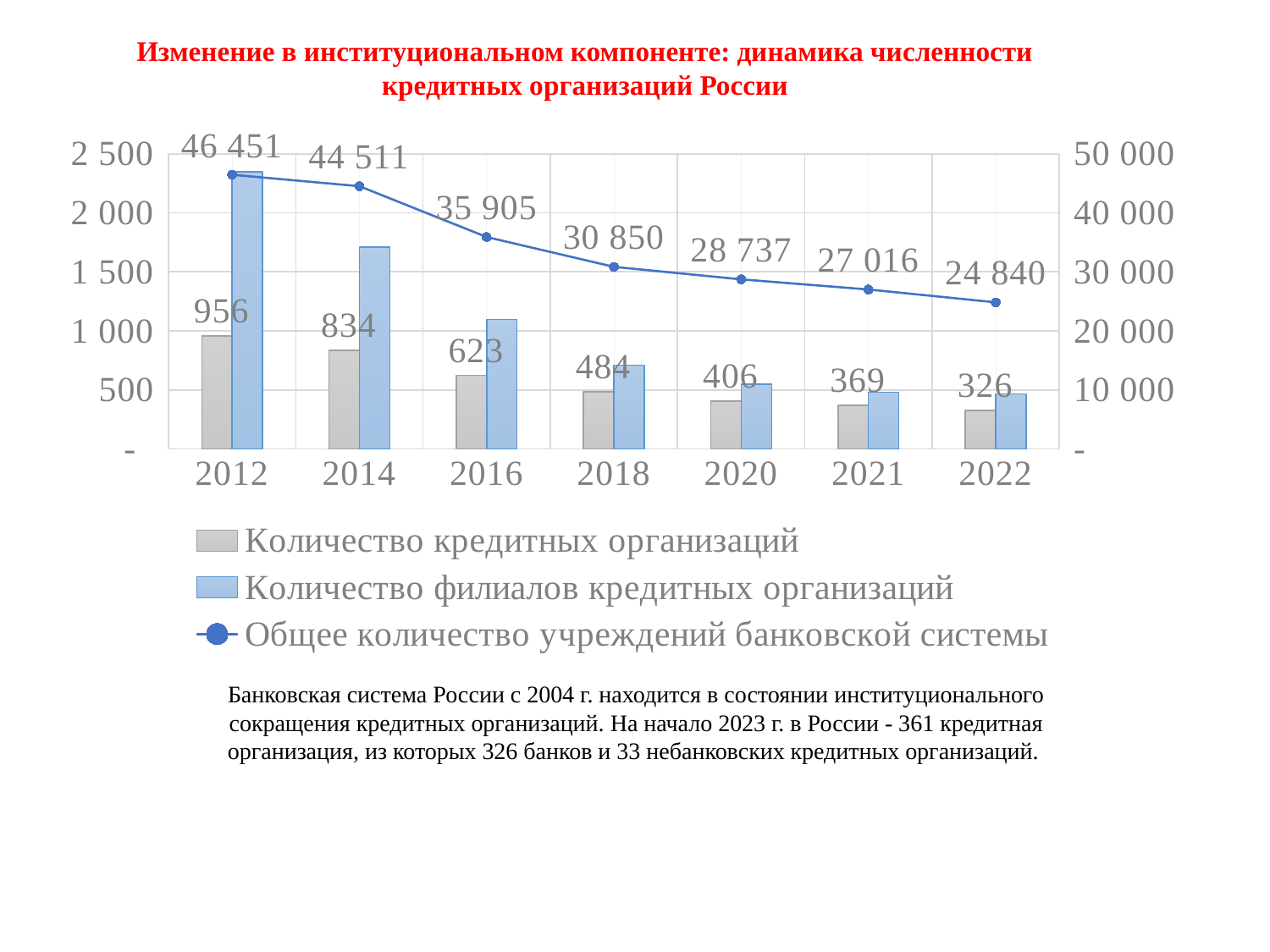
Do the values for 'Общее количество учреждений банковской системы' rise or fall from 2012 to 2022? fall By how much did 'Общее количество учреждений банковской системы' fall from 2012 to 2022? 21 611 How many years are shown on the x axis? 7 Which year has the larger value for 'Количество кредитных организаций', 2018 or 2020? 2018 What is the value for 'Общее количество учреждений банковской системы' in 2016? 35 905 In which year is 'Количество кредитных организаций' highest? 2012 In which year is 'Общее количество учреждений банковской системы' lowest? 2022 How many series does the legend list? 3 What is the value for 'Количество кредитных организаций' in 2022? 326 Is the value for 'Количество филиалов кредитных организаций' in 2012 greater or less than 2 000? greater What is the difference between 'Количество кредитных организаций' in 2012 and in 2022? 630 What is the value for 'Количество кредитных организаций' in 2012? 956